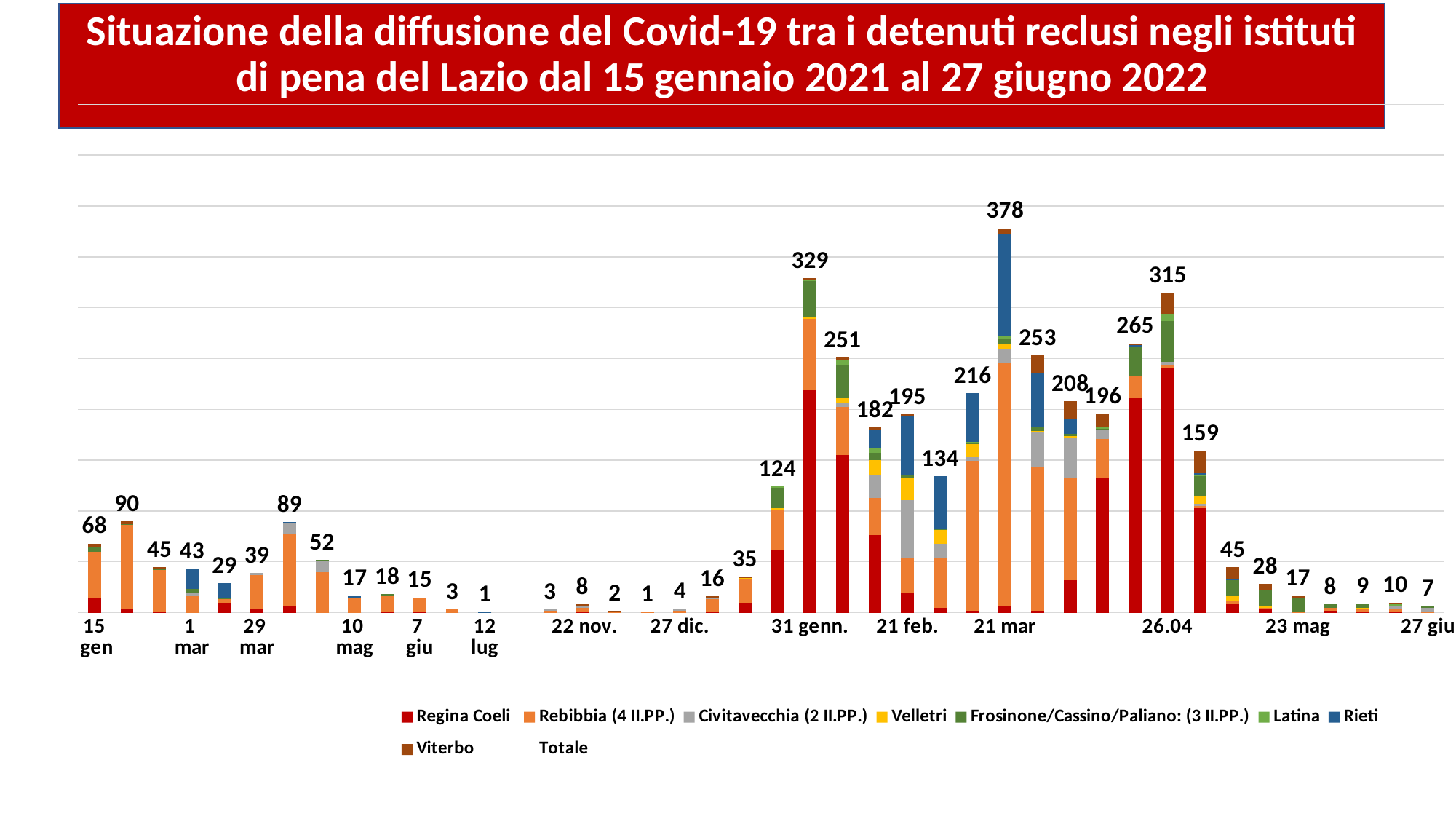
What is the total value shown for 21 mar? 378 Which date has the highest total? 21 mar How many series does the legend list? 9 What kind of chart is shown on the slide? Stacked bar chart Which series is shown in red in the legend? Regina Coeli What is the total value shown for 31 genn.? 329 What is the highest total value labelled on the chart? 378 What is the total value shown for 26.04? 315 Which has a larger total, 31 genn. or 26.04? 31 genn. What is the total value shown for 27 giu? 7 What is the difference between the totals for 21 mar and 26.04? 63 What is the total value shown for 15 gen? 68